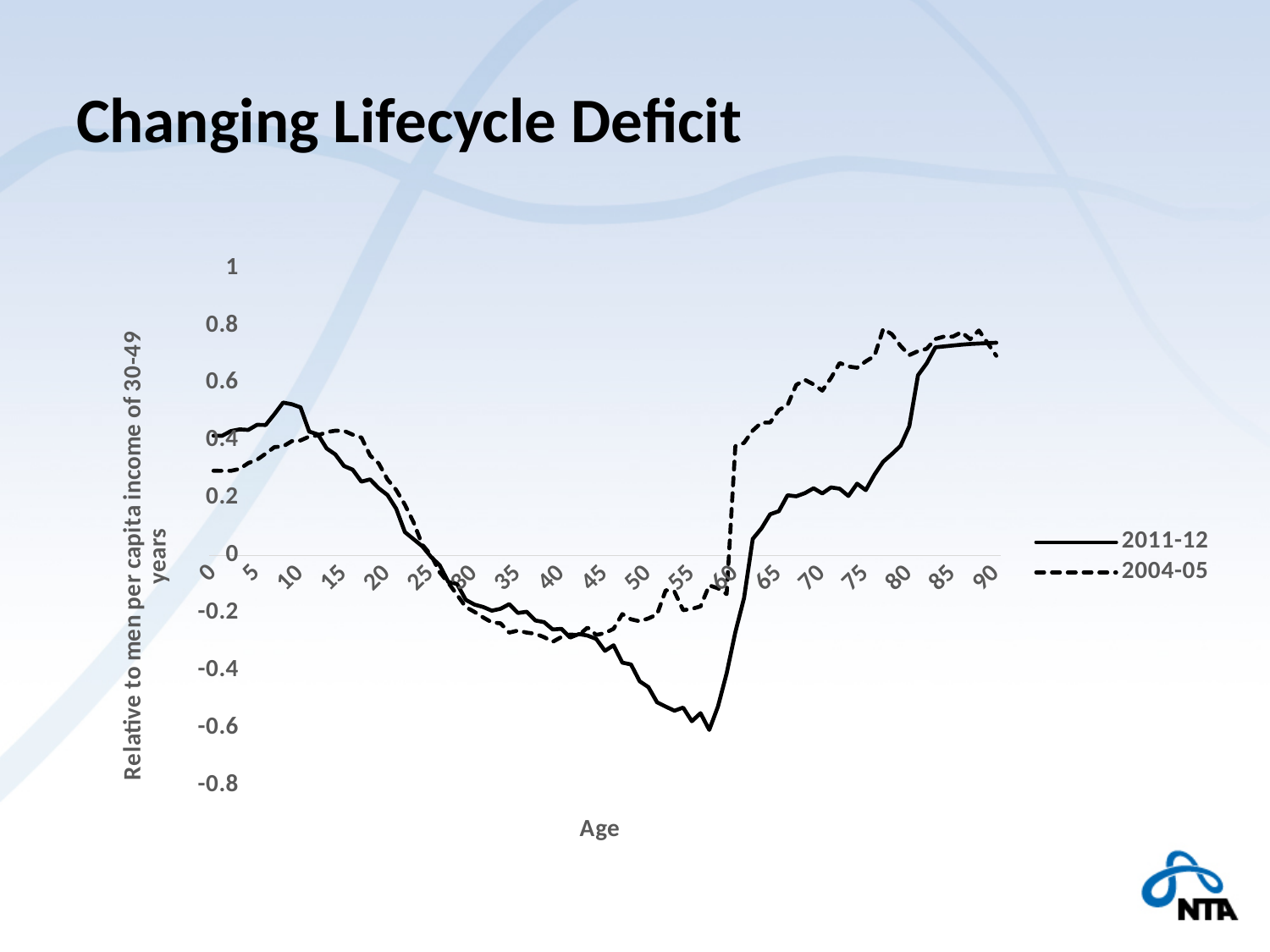
Which series reaches the lower minimum value over the age range? 2011-12 Is the value of the 2004-05 series at age 70 greater or less than 0.4? greater What is the title of the chart on the slide? Changing Lifecycle Deficit Does the 2011-12 series rise or fall between age 25 and age 55? fall Is the value of the 2004-05 series at age 0 greater or less than 0.2? greater Is the value of the 2011-12 series at age 55 greater or less than -0.4? less What kind of chart is shown on the slide? line chart How many series does the legend list? 2 At age 0, which series has the higher value, 2011-12 or 2004-05? 2011-12 At age 55, which series has the higher value, 2011-12 or 2004-05? 2004-05 Which series is drawn with a dashed line? 2004-05